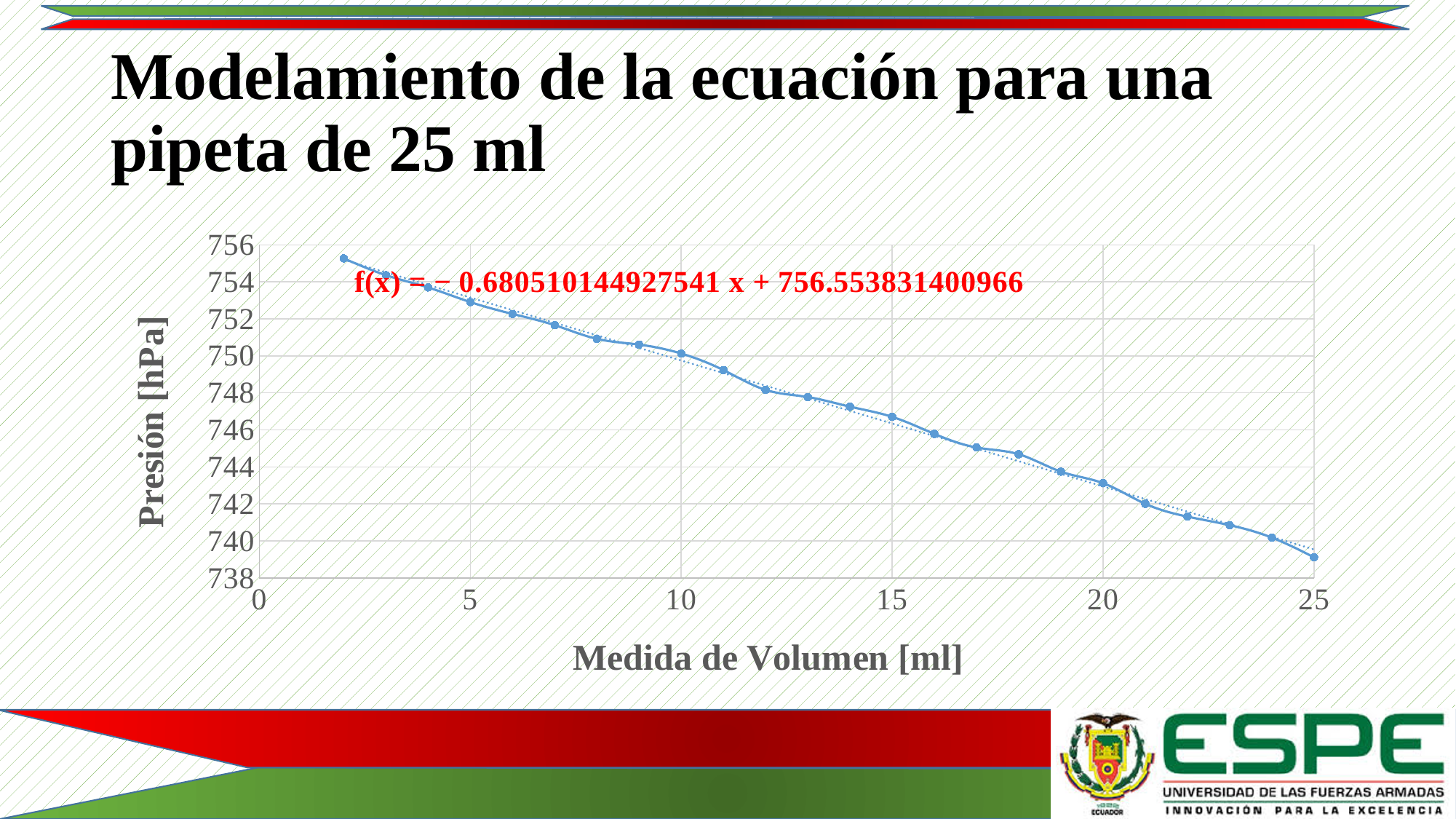
Is the pressure value at a volume of 25 ml greater or less than 740? less Do the pressure values rise or fall as the volume increases along the x axis? fall What is the title of the y axis? Presión [hPa] What is the trendline equation shown on the chart? f(x) = − 0.680510144927541 x + 756.553831400966 Which has the larger pressure value: the point at 15 ml or the point at 22 ml? 15 ml Is the pressure value at a volume of 10 ml greater or less than 748? greater At which volume measurement is the pressure lowest? 25 What kind of chart is shown on the slide? line chart Is the pressure value at a volume of 5 ml greater or less than 752? greater